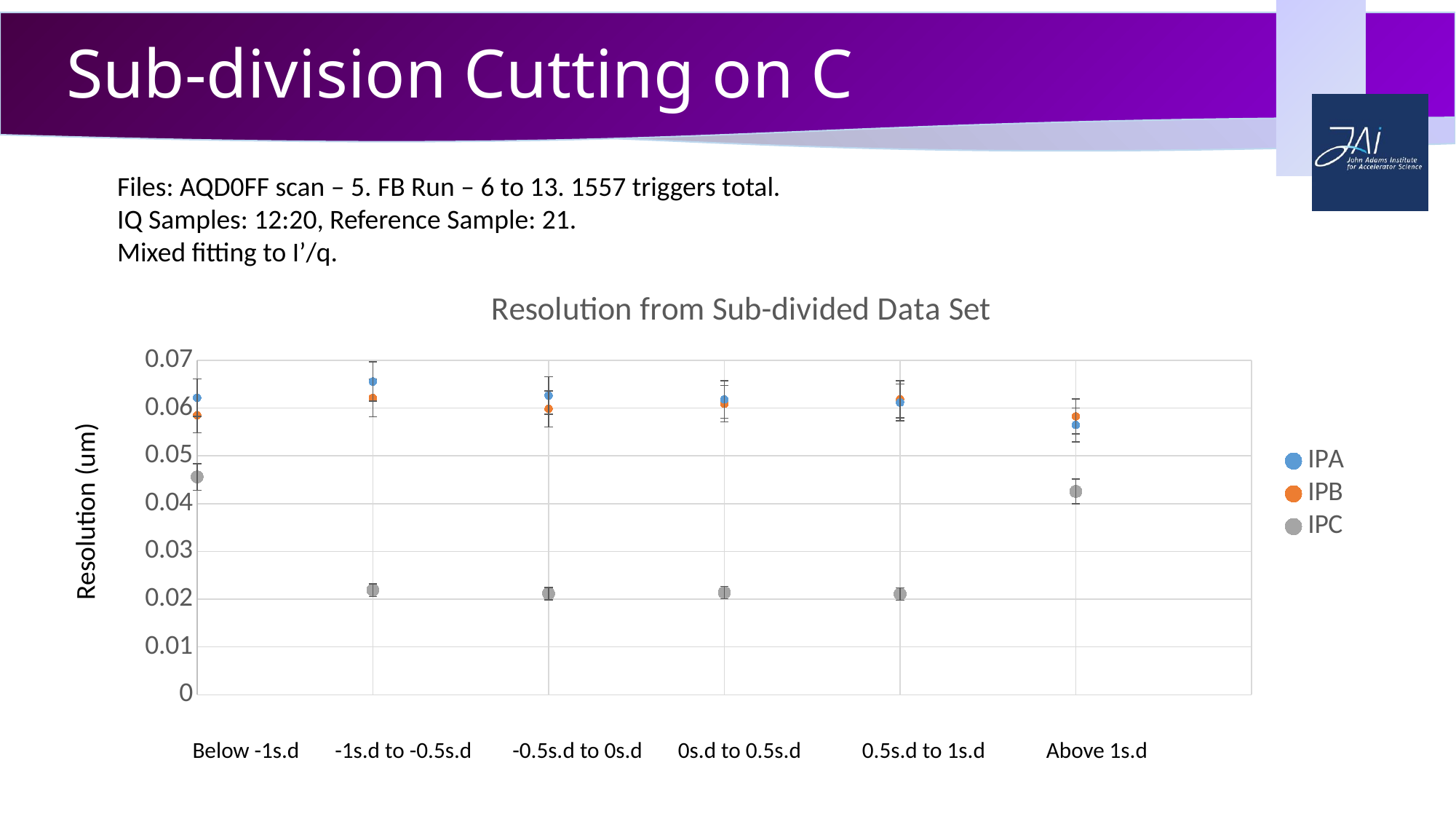
Which is larger for 0s.d to 0.5s.d, the IPA value or the IPC value? IPA What is the label of the y axis of the chart? Resolution (um) What kind of chart is shown on the slide? Scatter chart How many categories are shown along the x axis of the chart? 6 For which category is the IPC value highest? Below -1s.d Is the IPC value for Below -1s.d greater or less than 0.04? greater Is the IPA value for -1s.d to -0.5s.d greater or less than 0.06? greater For which category is the IPA value lowest? Above 1s.d What is the title of the chart? Resolution from Sub-divided Data Set Is the IPC value for -0.5s.d to 0s.d greater or less than 0.03? less For which category is the IPA value highest? -1s.d to -0.5s.d How many series does the chart legend list? 3